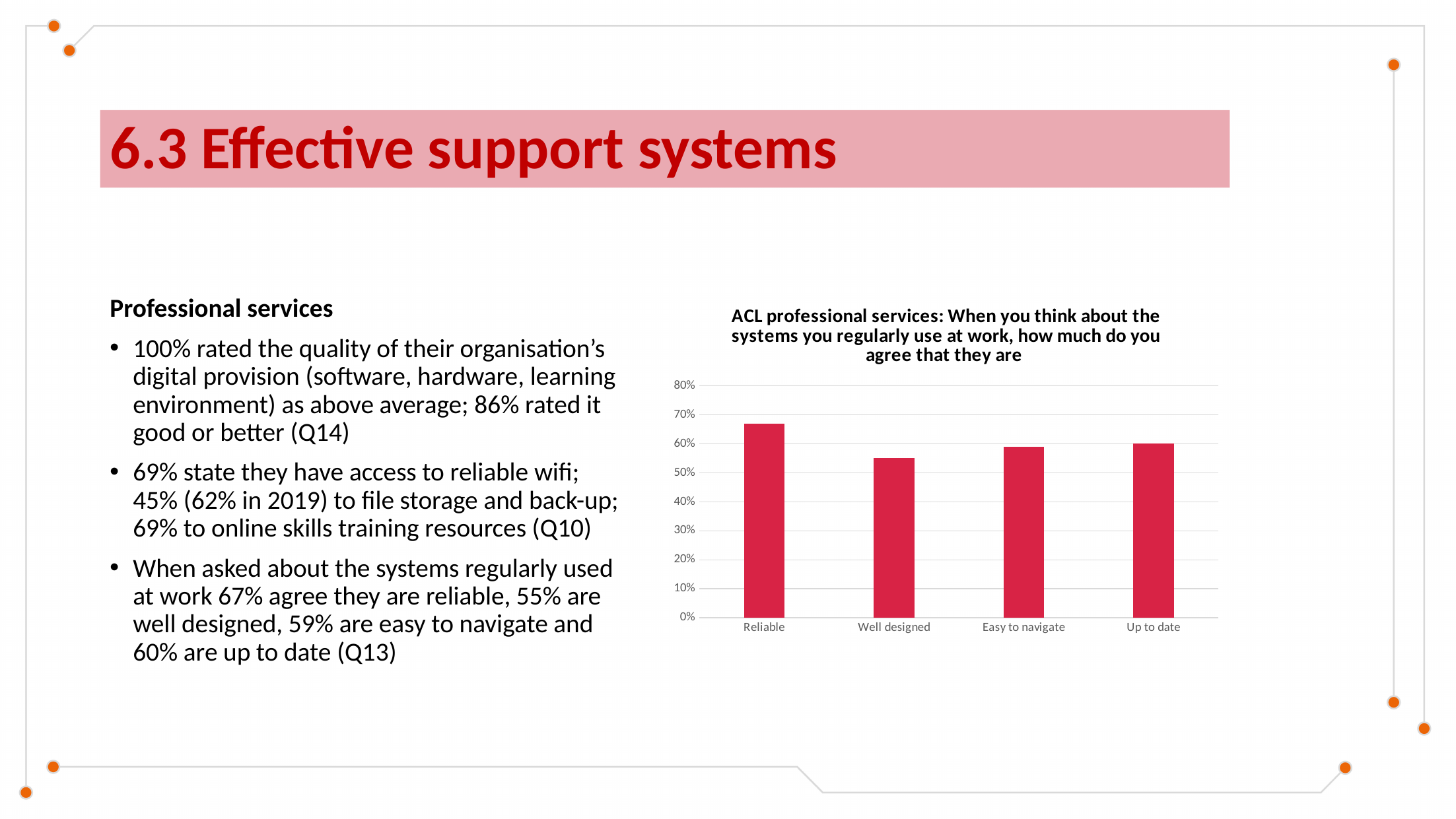
How many categories are shown on the x axis of the chart? 4 Which is larger, the value for Reliable or the value for Well designed? Reliable Which category has the highest bar in the chart? Reliable Which category has the lowest bar in the chart? Well designed What is the highest value shown on the chart's vertical axis? 80% What kind of chart is shown on the slide? bar chart What colour are the bars in the chart? red Is the value for Easy to navigate greater or less than 50%? greater Is the value for Reliable greater or less than 60%? greater Is the value for Up to date greater or less than 70%? less Which is larger, the value for Up to date or the value for Well designed? Up to date